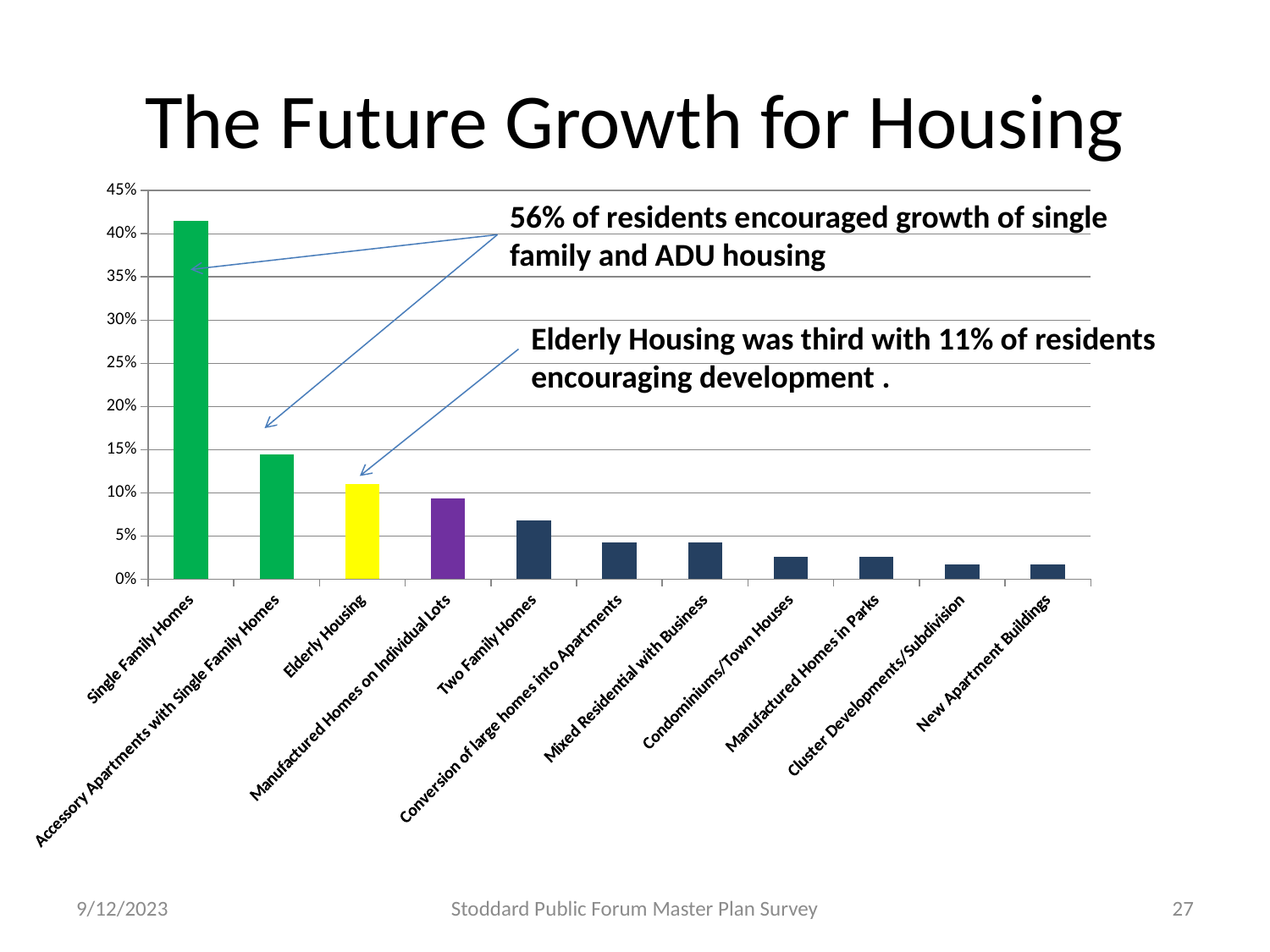
Which is larger, the value for Single Family Homes or the value for Two Family Homes? Single Family Homes What kind of chart is shown on the slide? bar chart According to the slide's annotation, what percentage of residents encouraged development of Elderly Housing? 11% Is the value for Two Family Homes greater or less than 5%? greater Is the value for Single Family Homes greater or less than 35%? greater How many housing categories are plotted on the chart? 11 Is the value for Manufactured Homes on Individual Lots greater or less than 10%? less Which housing category has the highest value on the chart? Single Family Homes What colour is the bar for Elderly Housing? yellow Do the values generally rise or fall moving from left to right along the x axis? fall